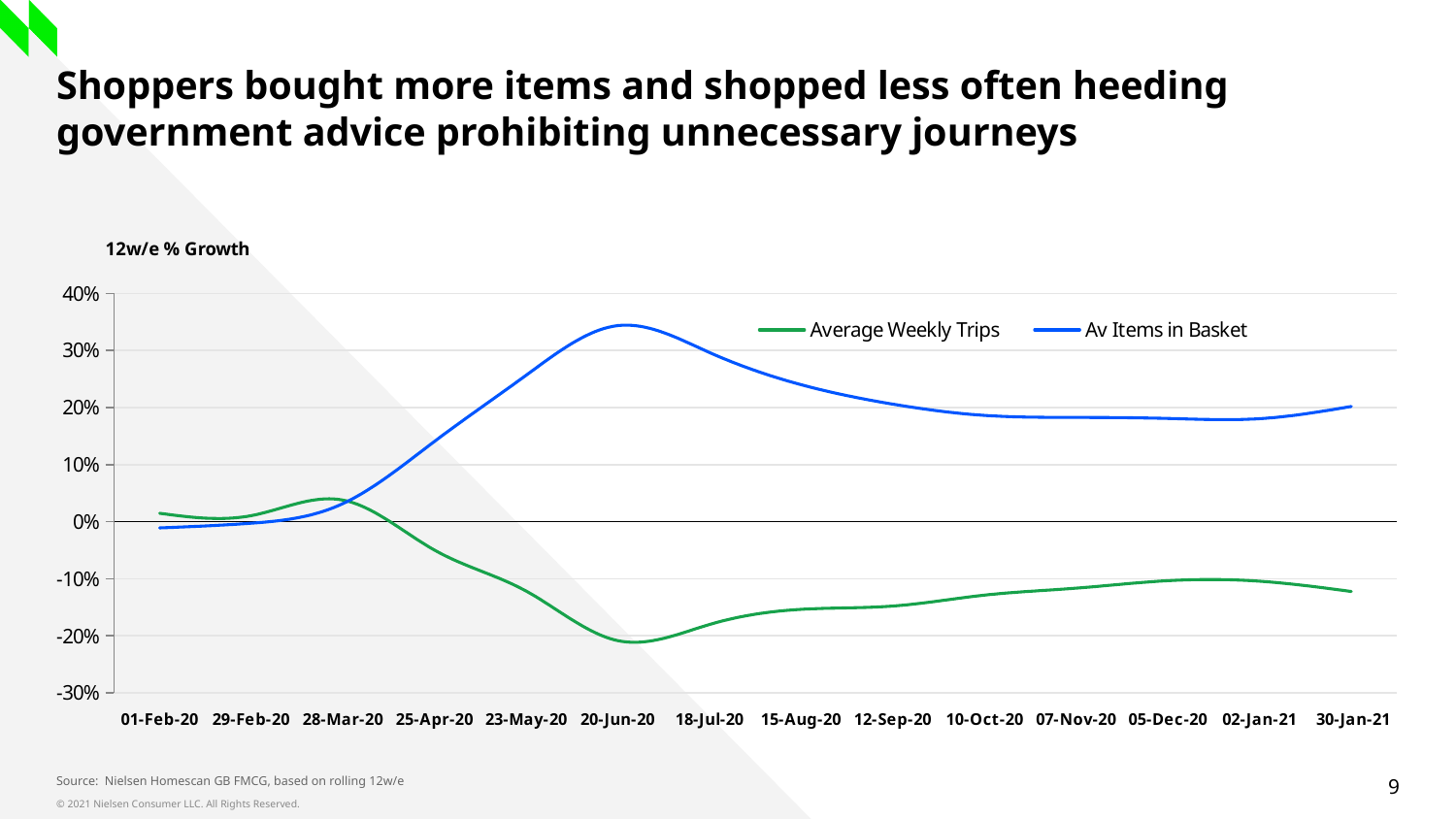
Is the value for Av Items in Basket at 30-Jan-21 greater or less than 10%? greater Does Av Items in Basket rise or fall between 01-Feb-20 and 20-Jun-20? Rise How many dates are labelled along the x axis? 14 At 30-Jan-21, which series has the larger value, Average Weekly Trips or Av Items in Basket? Av Items in Basket What is the title of the chart? 12w/e % Growth What kind of chart is shown on the slide? Line chart At which date does Average Weekly Trips reach its lowest value? 20-Jun-20 How many series does the legend list? 2 Which series is drawn in blue? Av Items in Basket Is the value for Av Items in Basket at 20-Jun-20 greater or less than 30%? greater At which date does Av Items in Basket reach its highest value? 20-Jun-20 Is the value for Average Weekly Trips at 20-Jun-20 greater or less than -10%? less